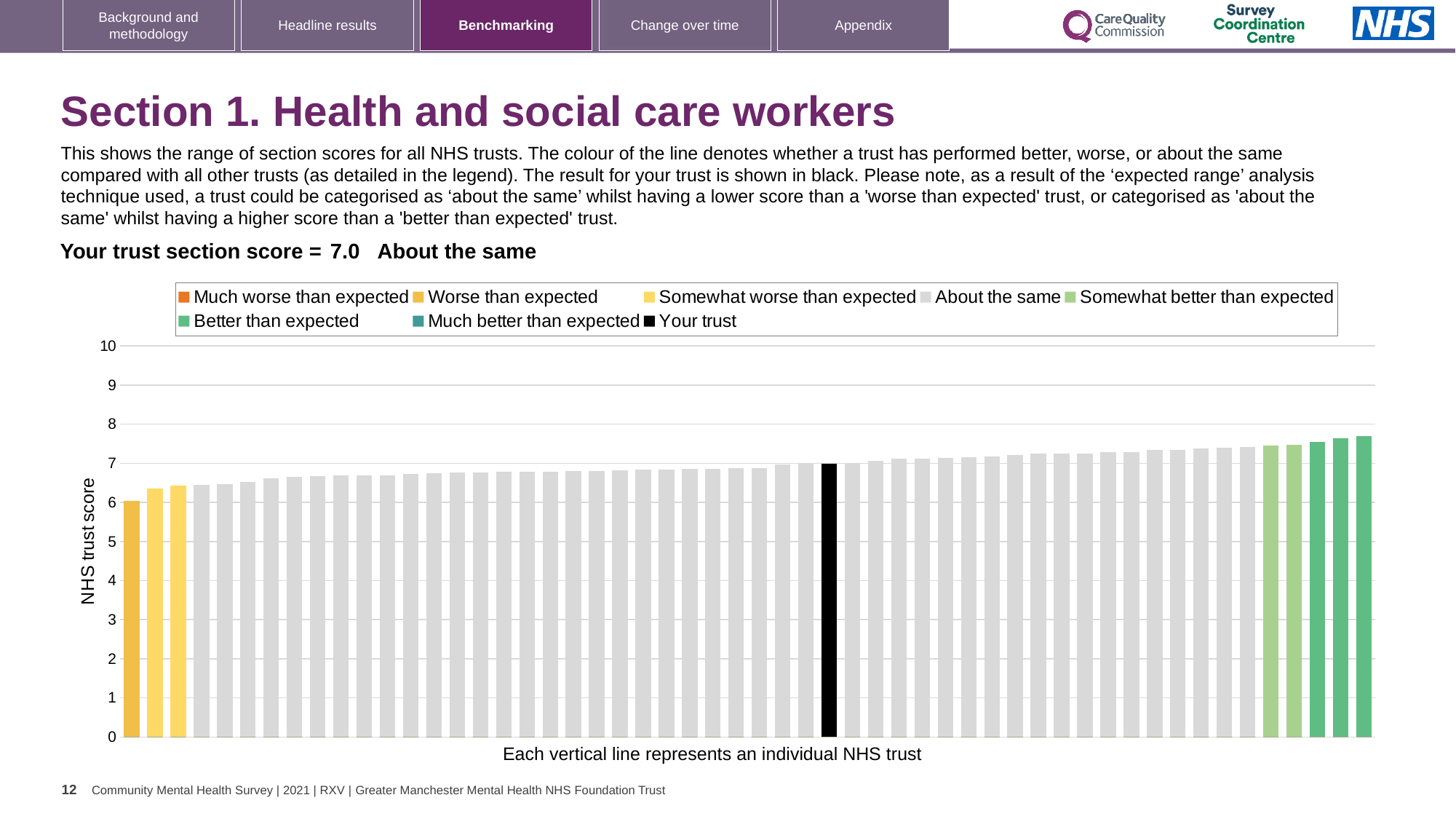
Do the bar values rise or fall from left to right across the chart? rise Is the value of the highest bar on the chart greater or less than 8? less Is the value of the lowest bar on the chart greater or less than 7? less Is the value of the highest bar on the chart greater or less than 7? greater What is the section score for your trust shown on the chart? 7.0 How many bars are coloured as 'Somewhat better than expected' (light green) on the chart? 2 Which benchmarking category is your trust placed in for this section? About the same What is the label on the vertical axis of the chart? NHS trust score How many entries does the chart legend list? 8 What colour is the bar representing your trust? black How many bars are coloured as 'Worse than expected' (yellow) on the chart? 1 What kind of chart is shown on the slide? bar chart